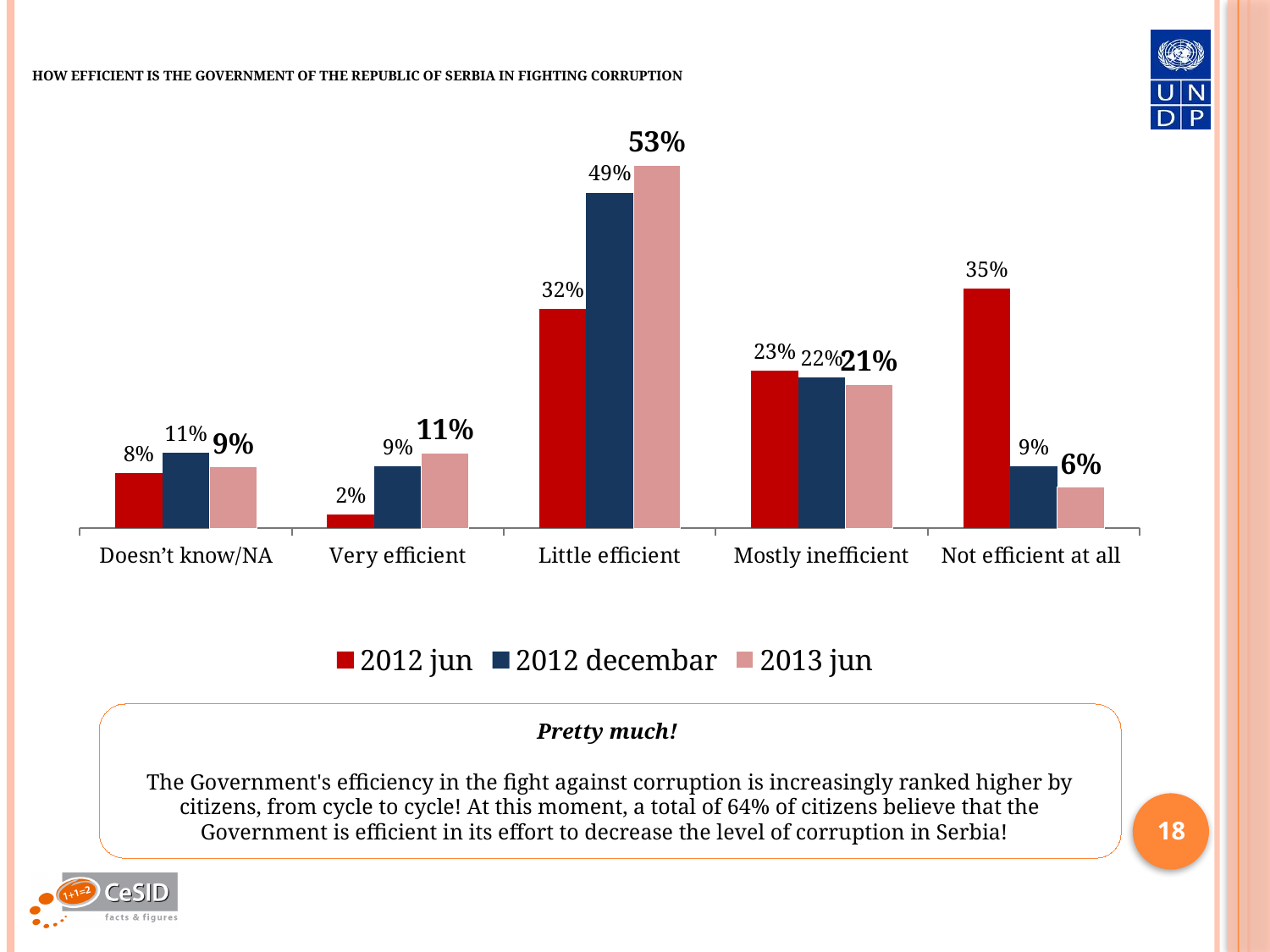
What is the difference between the 2013 jun and 2012 jun values for "Little efficient"? 21% Which series is shown in the lightest (pink) colour in the legend? 2013 jun What is the value for "Mostly inefficient" in the 2013 jun series? 21% Which category has the highest value in the 2012 decembar series? Little efficient What kind of chart is shown on the slide? Bar chart Which is larger for "Not efficient at all": the 2012 jun value or the 2013 jun value? 2012 jun What is the value for "Not efficient at all" in the 2012 jun series? 35% What is the value for "Little efficient" in the 2013 jun series? 53% What is the value for "Very efficient" in the 2012 decembar series? 9% How many categories are shown on the x axis? 5 Which category has the lowest value in the 2012 jun series? Very efficient How many series does the legend list? 3